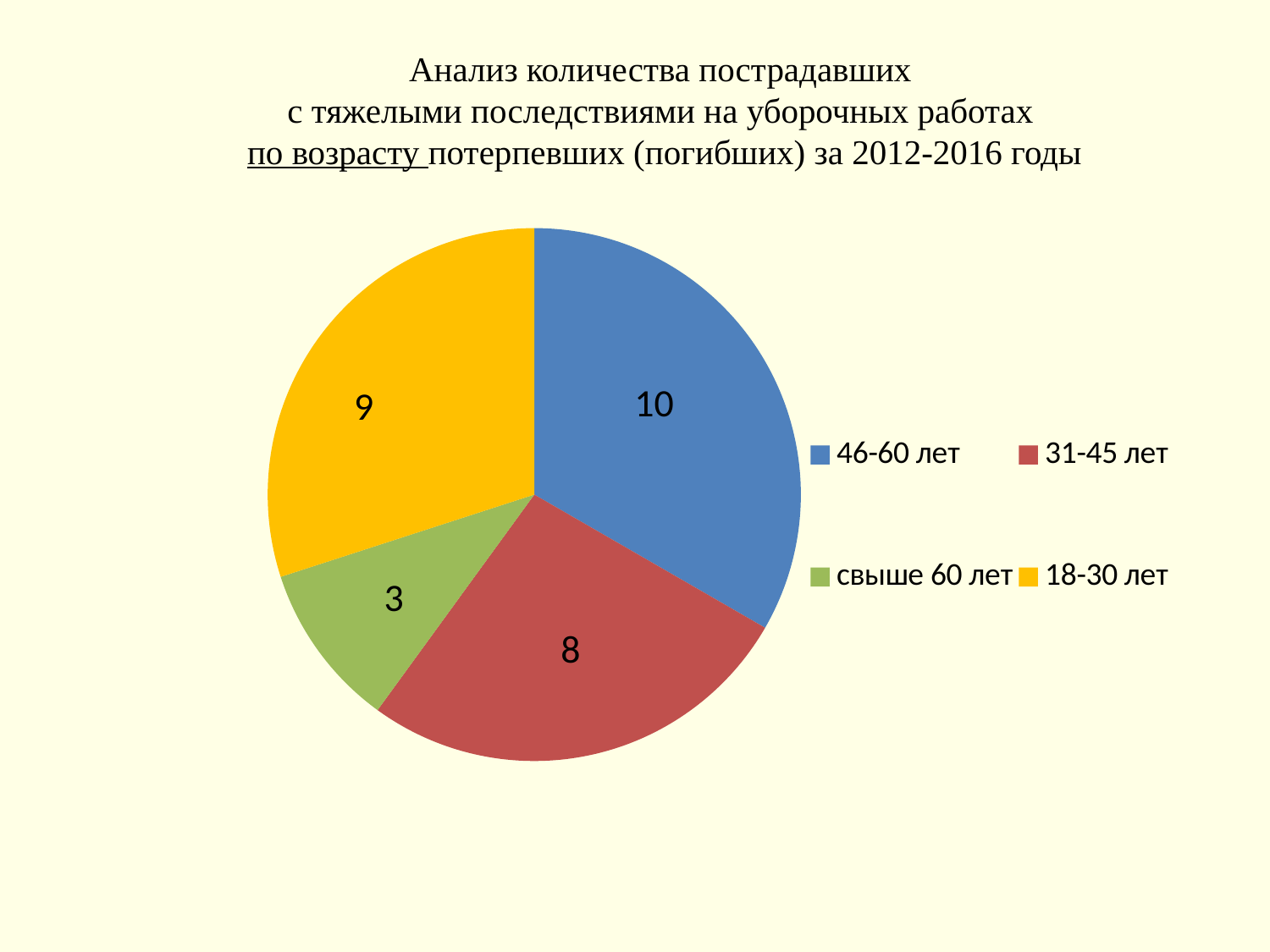
What is the value for the 31-45 лет slice? 8 Which age group has the largest slice? 46-60 лет What share of the pie does the свыше 60 лет slice represent? 10% What is the value for the свыше 60 лет slice? 3 What is the value for the 18-30 лет slice? 9 How many slices does the pie chart have? 4 What is the value for the 46-60 лет slice? 10 What type of chart is shown on the slide? pie chart What is the difference between the values for 46-60 лет and свыше 60 лет? 7 What colour is the slice for 18-30 лет? yellow Which is larger, the value for 18-30 лет or the value for 31-45 лет? 18-30 лет Which age group has the smallest slice? свыше 60 лет